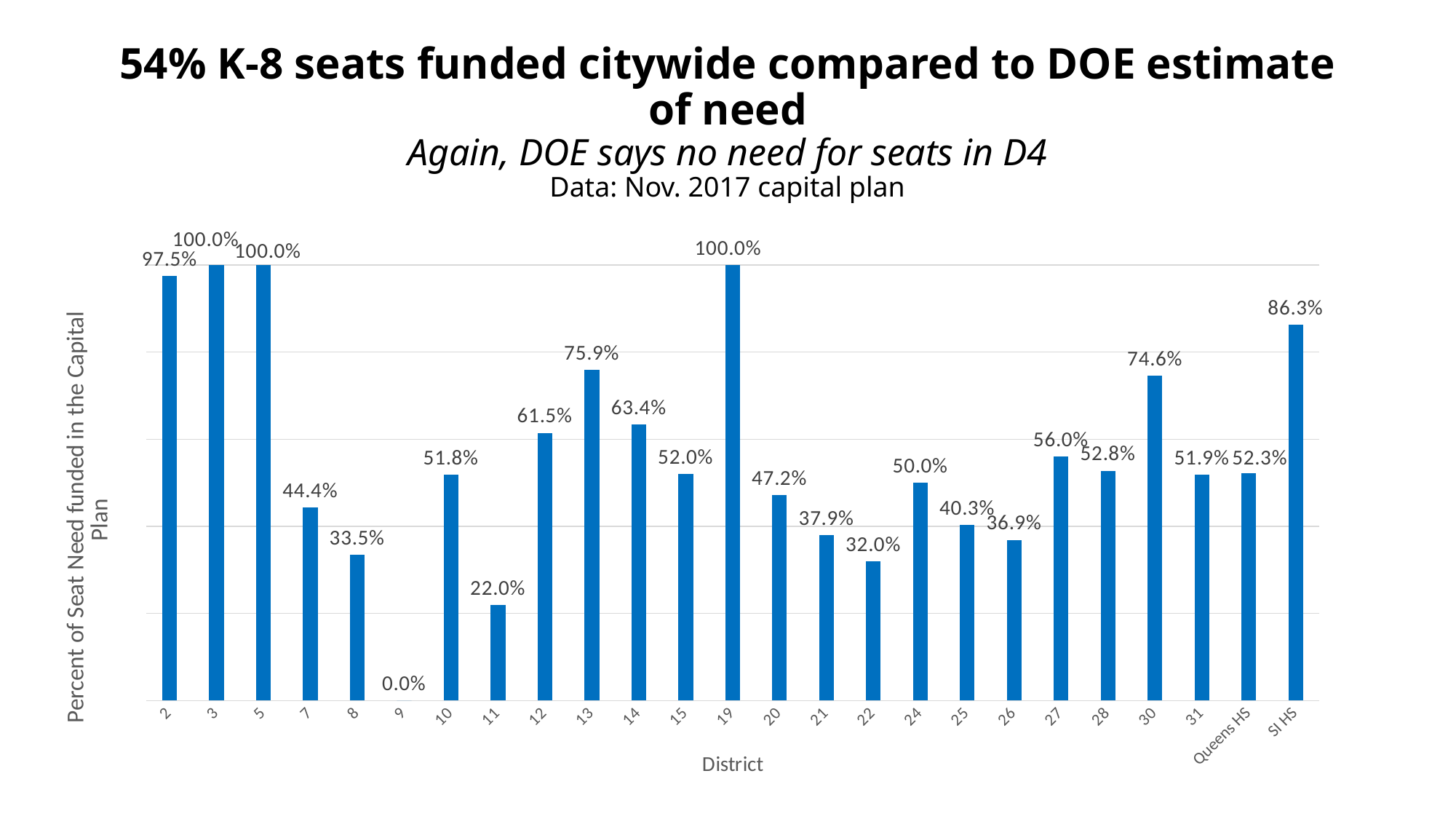
What percent of seat need is funded for District 11? 22.0% How many districts or categories are shown on the x axis? 25 Which has a higher percent funded, District 12 or District 14? 14 What is the difference between the values for District 2 and District 8? 64.0% What percent of seat need is funded in the capital plan for District 13? 75.9% What is the value shown for SI HS? 86.3% What is the difference between the values for District 30 and District 27? 18.6% Which has a lower percent funded, District 22 or District 26? 22 What is the label of the y axis? Percent of Seat Need funded in the Capital Plan What type of chart is shown on the slide? bar chart What is the value shown for Queens HS? 52.3% Which district has the lowest percent of seat need funded? 9